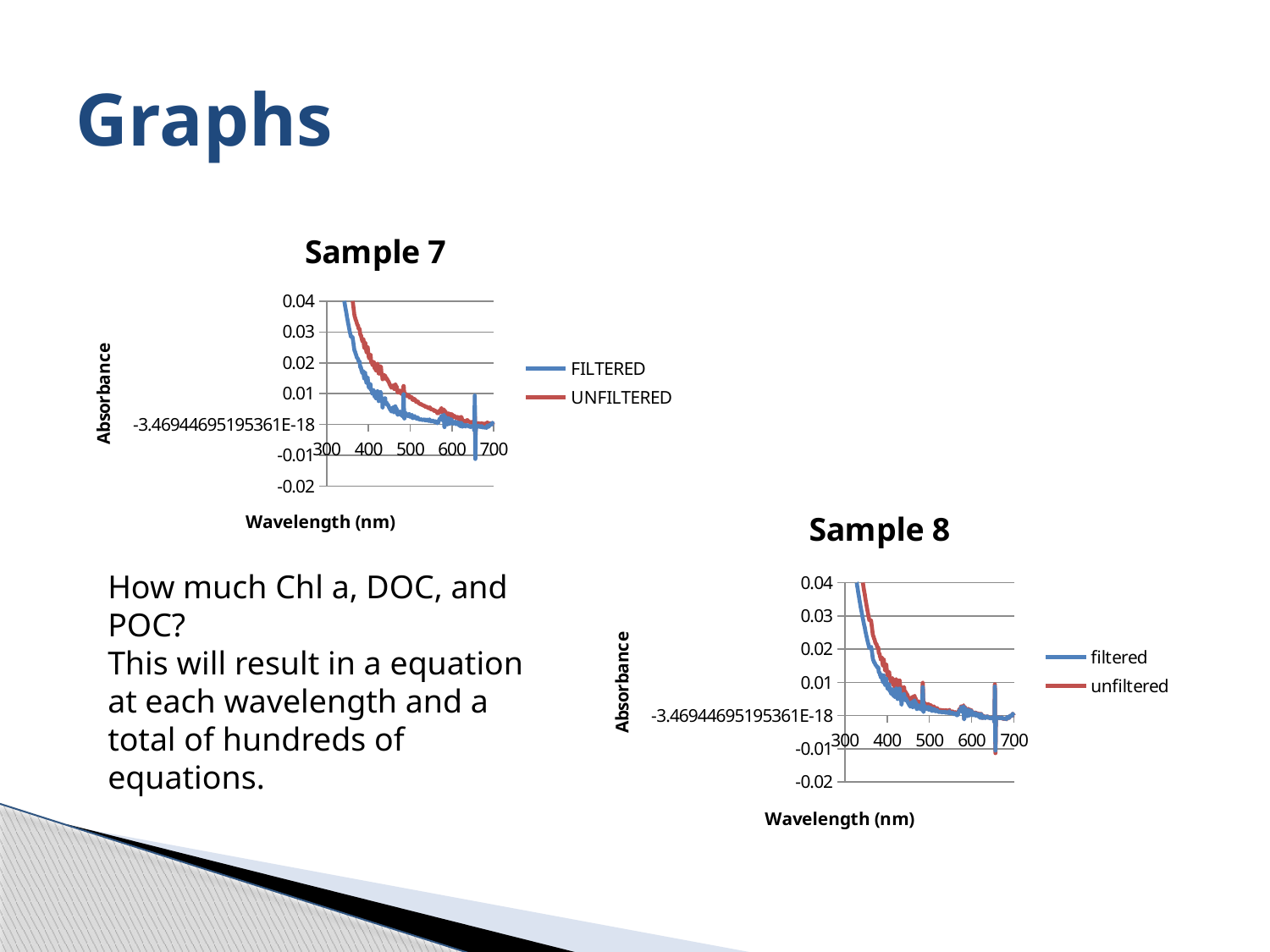
What is the x-axis title of the Sample 8 chart? Wavelength (nm) In the Sample 7 chart, is the FILTERED absorbance at 600 nm greater or less than 0.01? less In the Sample 8 chart, do the absorbance values rise or fall as wavelength increases from 300 to 700 nm? fall In the Sample 8 chart, which series has the higher absorbance at 400 nm, filtered or unfiltered? unfiltered What kind of chart is the Sample 7 chart? line chart What kind of chart is the Sample 8 chart? line chart How many series does the legend of the Sample 8 chart list? 2 In the Sample 7 chart, what colour is the UNFILTERED line? red In the Sample 7 chart, which series has the higher absorbance at 400 nm, FILTERED or UNFILTERED? UNFILTERED How many series does the legend of the Sample 7 chart list? 2 In the Sample 8 chart, is the unfiltered absorbance at 350 nm greater or less than 0.02? greater In the Sample 7 chart, do the absorbance values rise or fall as wavelength increases from 300 to 700 nm? fall